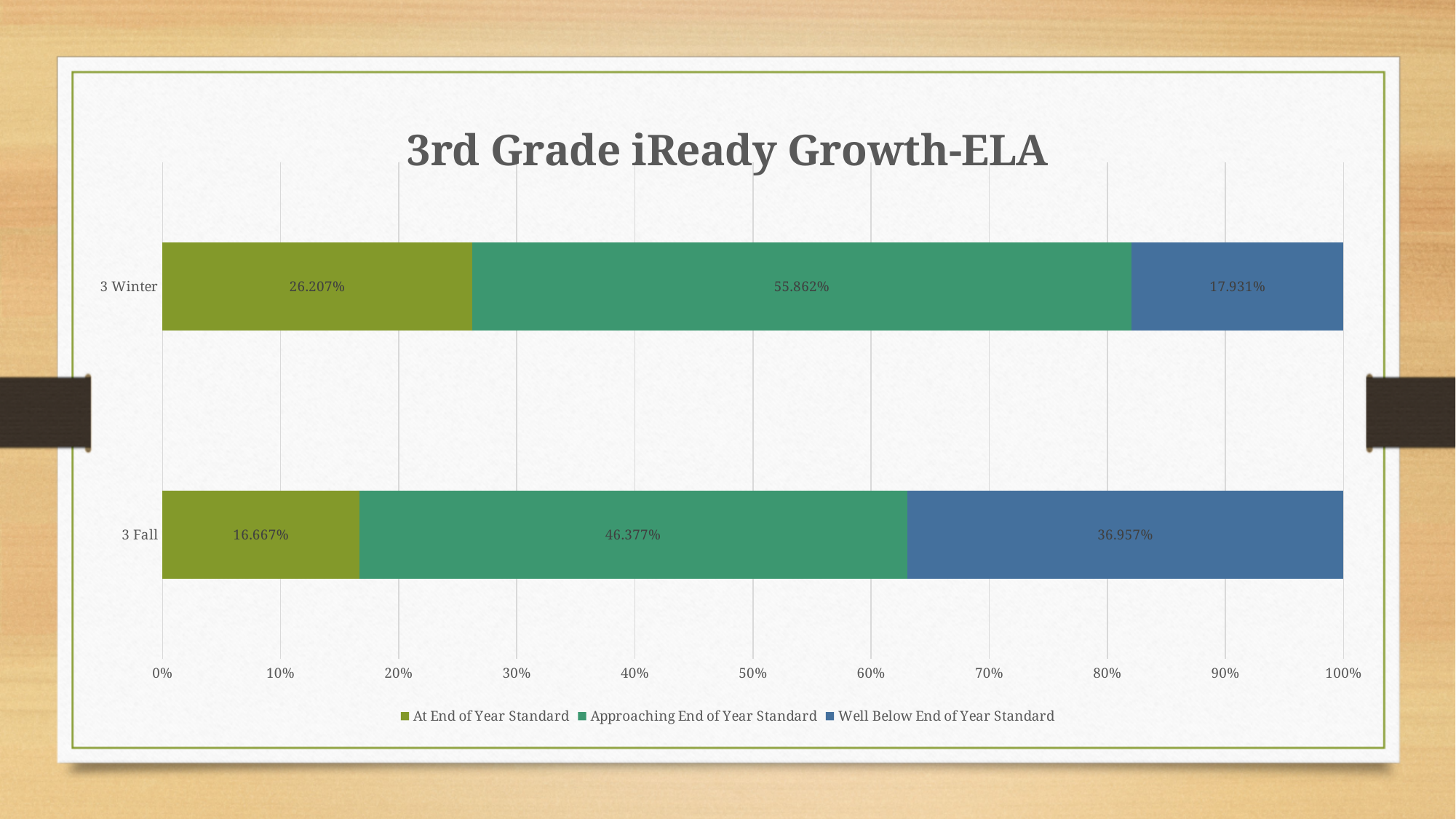
What is the title of the chart? 3rd Grade iReady Growth-ELA What is the value for At End of Year Standard in 3 Fall? 16.667% Which series has the largest value in the 3 Winter bar? Approaching End of Year Standard Which series has the smallest value in the 3 Fall bar? At End of Year Standard Which is larger: the At End of Year Standard value for 3 Winter or for 3 Fall? 3 Winter What is the difference between the Well Below End of Year Standard values for 3 Fall and 3 Winter? 19.026% How many categories are shown on the vertical axis? 2 What is the value for Approaching End of Year Standard in 3 Fall? 46.377% What kind of chart is shown on the slide? Stacked bar chart What is the value for At End of Year Standard in 3 Winter? 26.207% What is the value for Well Below End of Year Standard in 3 Winter? 17.931% How many series does the legend list? 3